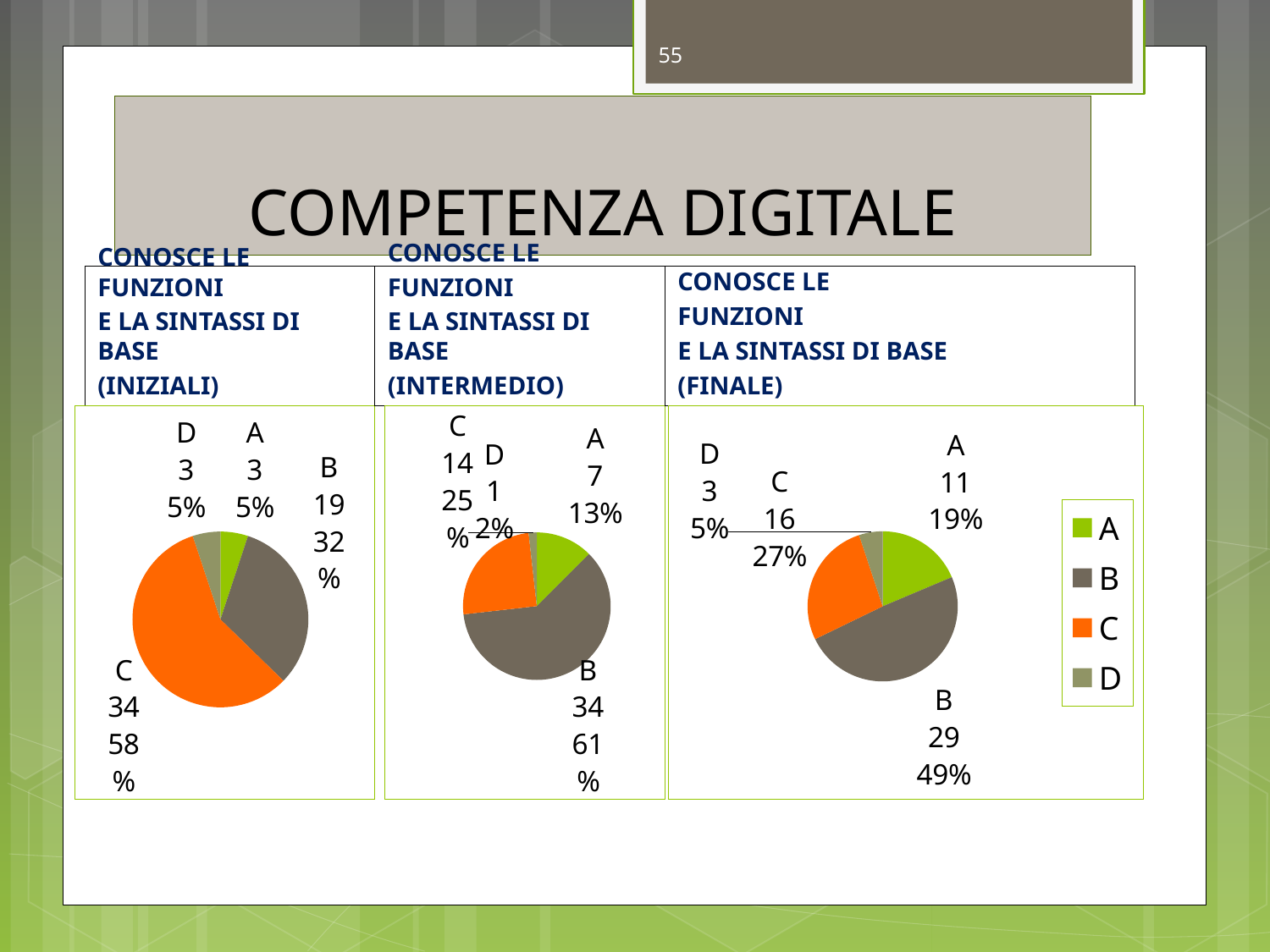
In the FINALE pie chart, what is the difference in count between category B and category C? 13 In the INIZIALI pie chart, what count is shown for category B? 19 In the FINALE pie chart, which is larger, the slice for C or the slice for A? C What type of chart is used on this slide? Pie chart In the FINALE pie chart, which category has the largest slice? B In the INIZIALI pie chart, which category has the largest slice? C In the INTERMEDIO pie chart, which category has the smallest slice? D In the INIZIALI pie chart, what percentage is shown for category C? 58% In the INTERMEDIO pie chart, what percentage is shown for category B? 61% In the INTERMEDIO pie chart, what count is shown for category C? 14 How many categories does the legend list? 4 In the FINALE pie chart, what percentage is shown for category A? 19%